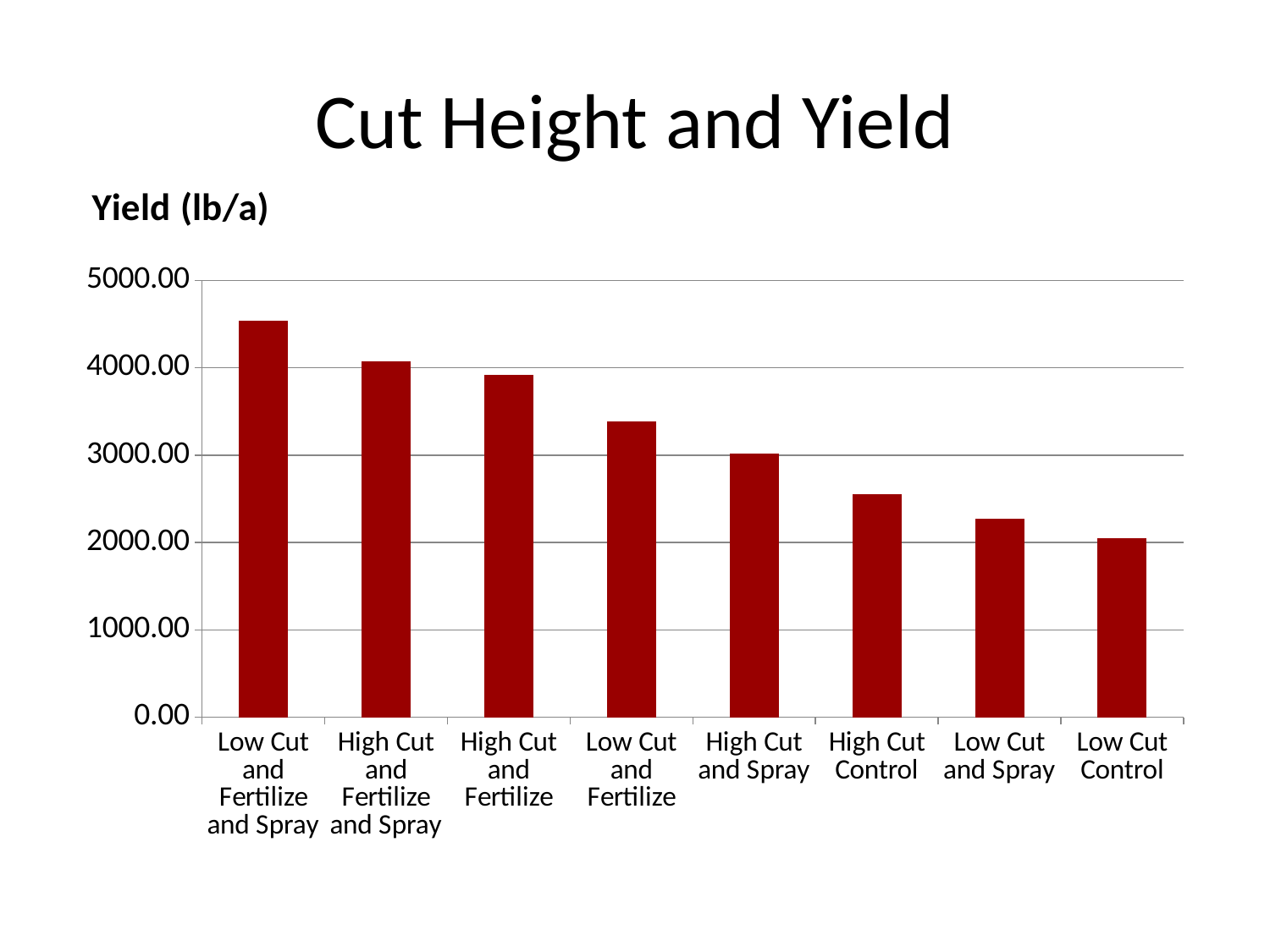
What unit label is shown above the chart's vertical axis? Yield (lb/a) What is the title of the slide? Cut Height and Yield Which is larger, the yield for High Cut and Fertilize or the yield for Low Cut and Fertilize? High Cut and Fertilize Is the value for High Cut Control greater or less than 3000.00? less What type of chart is shown on the slide? bar chart Do the bar values rise or fall from left to right along the x axis? fall Is the value for Low Cut and Fertilize greater or less than 3000.00? greater Is the value for Low Cut and Fertilize and Spray greater or less than 4000.00? greater Which category has the highest yield? Low Cut and Fertilize and Spray How many categories are shown on the x axis of the chart? 8 Which category has the lowest yield? Low Cut Control